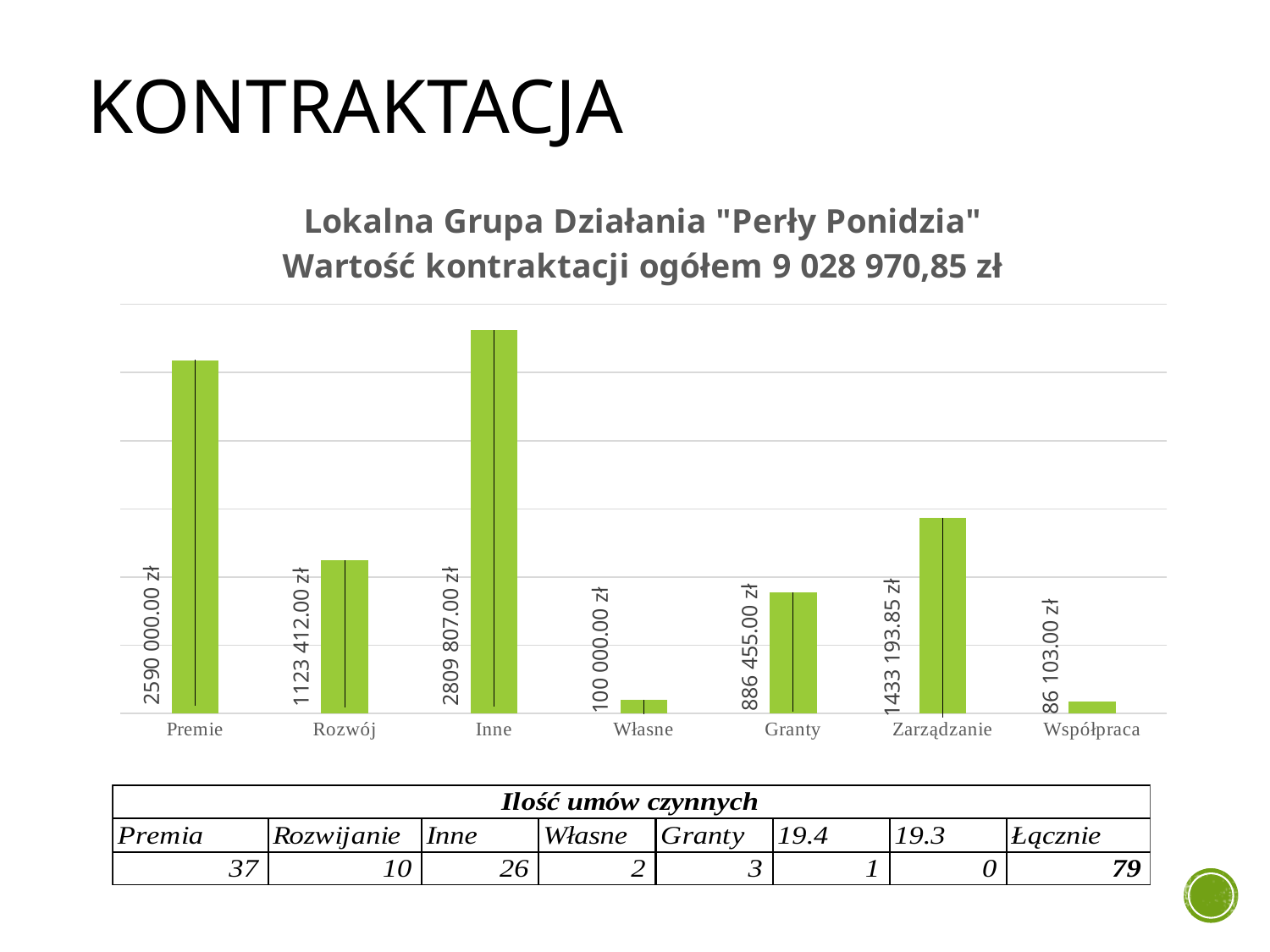
What total contract value is stated in the chart title? 9 028 970,85 zł Which category has the lowest value? Współpraca What is the value for Zarządzanie? 1433 193.85 zł Which category has the highest value? Inne How many categories are shown in the chart? 7 What kind of chart is shown on the slide? Bar chart What is the value for Premie? 2590 000.00 zł What is the difference between the values for Inne and Premie? 219 807.00 zł Which is larger, the value for Rozwój or the value for Granty? Rozwój What is the value for Granty? 886 455.00 zł What is the value for Współpraca? 86 103.00 zł What is the difference between the values for Zarządzanie and Granty? 546 738.85 zł